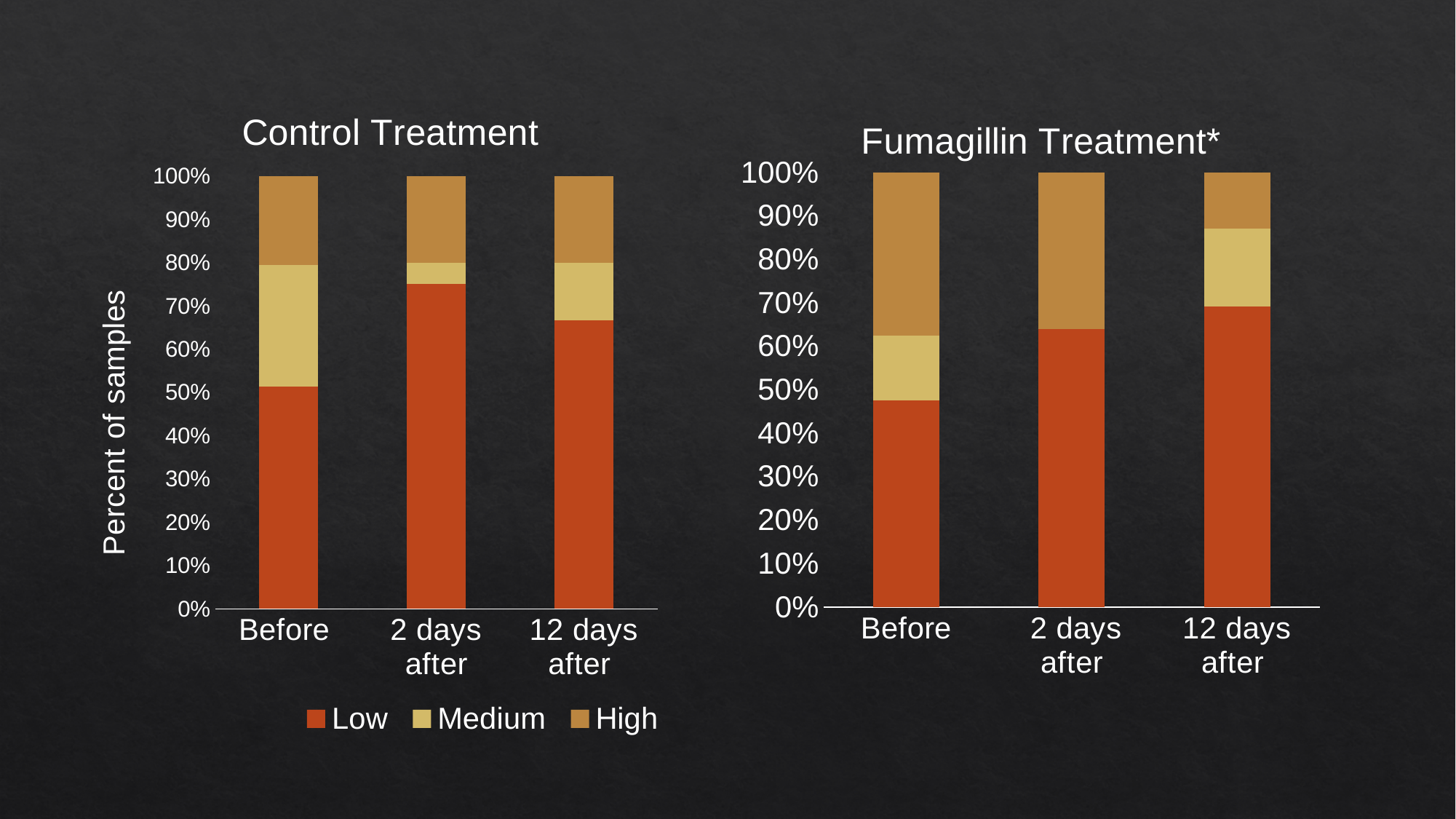
In the Fumagillin Treatment* chart, which category has the smallest Low segment? Before In the Fumagillin Treatment* chart, does the Low segment rise or fall from Before to 12 days after? rise In the Control Treatment chart, is the Low value for Before greater or less than 40%? greater How many series does the legend list? 3 In the Fumagillin Treatment* chart, is the Medium segment larger for Before or for 12 days after? 12 days after What kind of chart is the Control Treatment chart? stacked bar chart What is the label on the vertical axis of the Control Treatment chart? Percent of samples In the Control Treatment chart, is the Low value for 2 days after greater or less than 70%? greater In the Fumagillin Treatment* chart, is the Low value for Before greater or less than 50%? less In the Control Treatment chart, which category has the largest Low segment? 2 days after How many categories are shown on the x axis of the Fumagillin Treatment* chart? 3